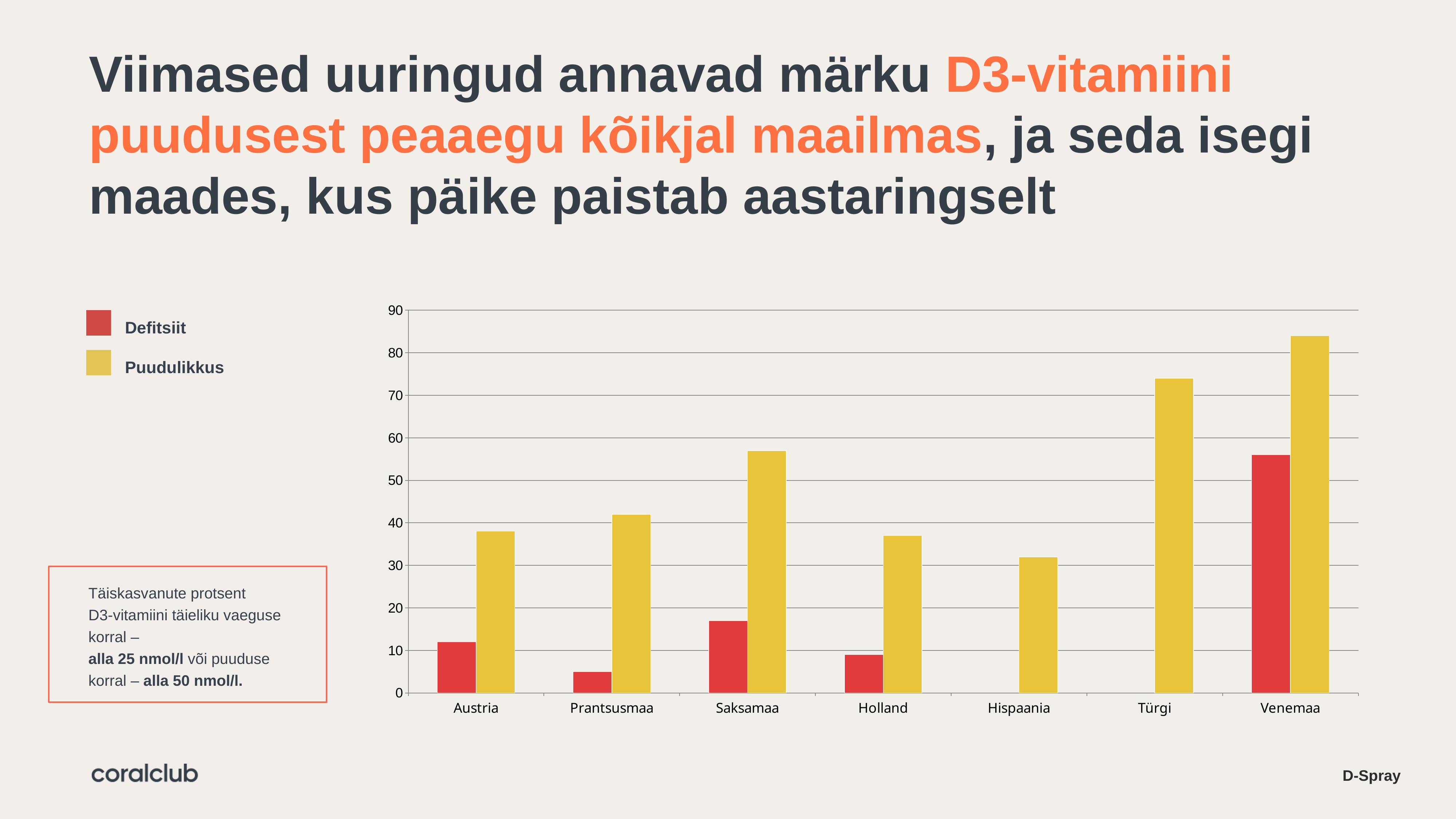
Which country has the highest Puudulikkus value? Venemaa Is the Defitsiit value for Prantsusmaa greater or less than 10? less Which is larger, the Puudulikkus value for Saksamaa or for Prantsusmaa? Saksamaa Which country has the lowest Puudulikkus value? Hispaania Is the Puudulikkus value for Türgi greater or less than 70? greater How many countries are shown on the x axis of the chart? 7 Which country has the highest Defitsiit value? Venemaa How many series does the chart legend list? 2 What kind of chart is shown on the slide? bar chart Which colour represents the Defitsiit series in the chart? red Is the Puudulikkus value for Venemaa greater or less than 80? greater